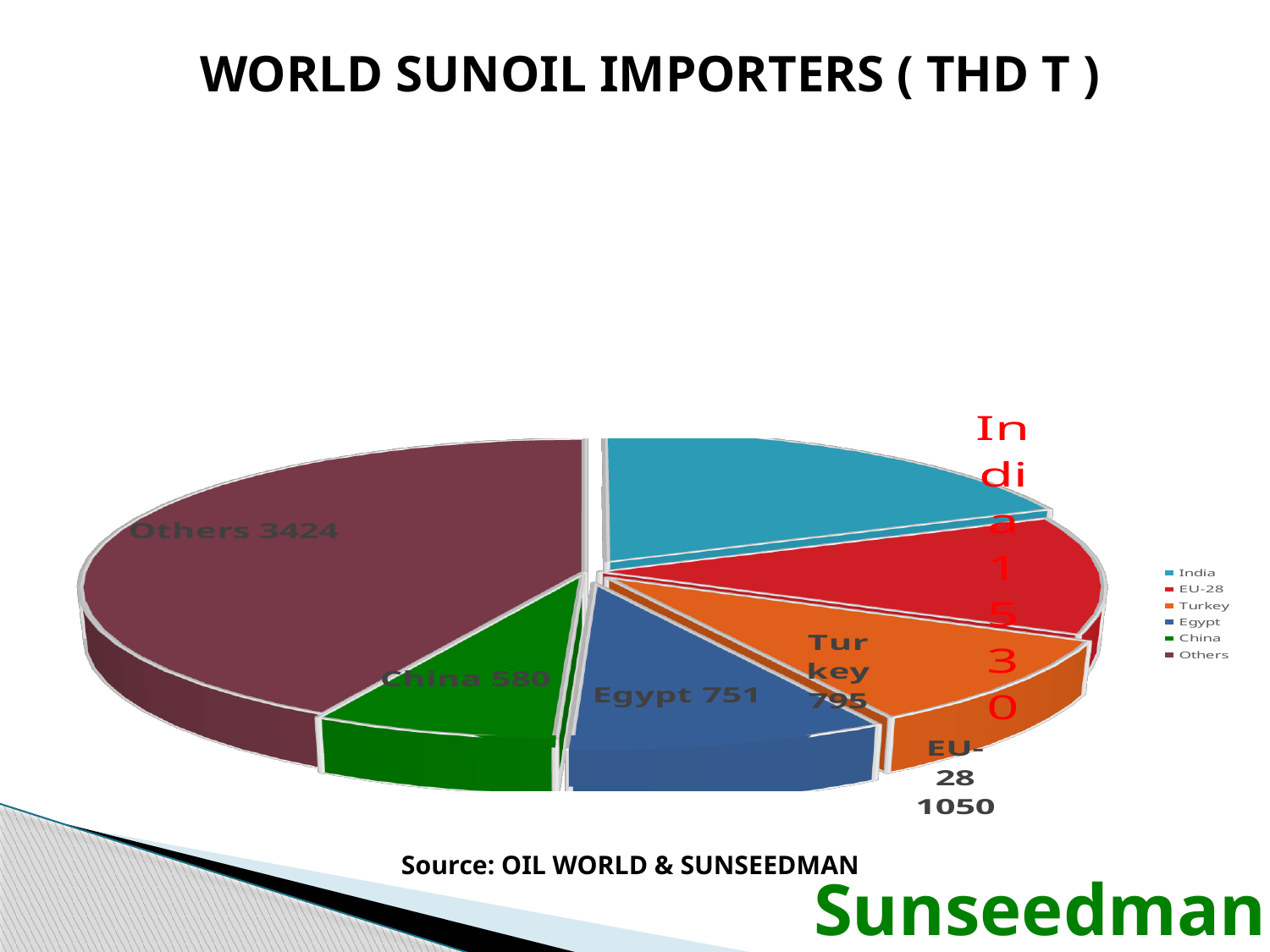
What type of chart is shown on the slide? Pie chart Which is larger, the value for Turkey or the value for Egypt? Turkey How many categories does the legend of the pie chart list? 6 What is the value for Others in the pie chart? 3424 Which category has the smallest slice of the pie chart? China Which category has the largest slice of the pie chart? Others What is the title of the chart on the slide? WORLD SUNOIL IMPORTERS ( THD T ) What is the difference between the values for EU-28 and Egypt? 299 What is the value for Turkey in the pie chart? 795 What is the value for Egypt in the pie chart? 751 What is the value for EU-28 in the pie chart? 1050 What is the value for China in the pie chart? 580